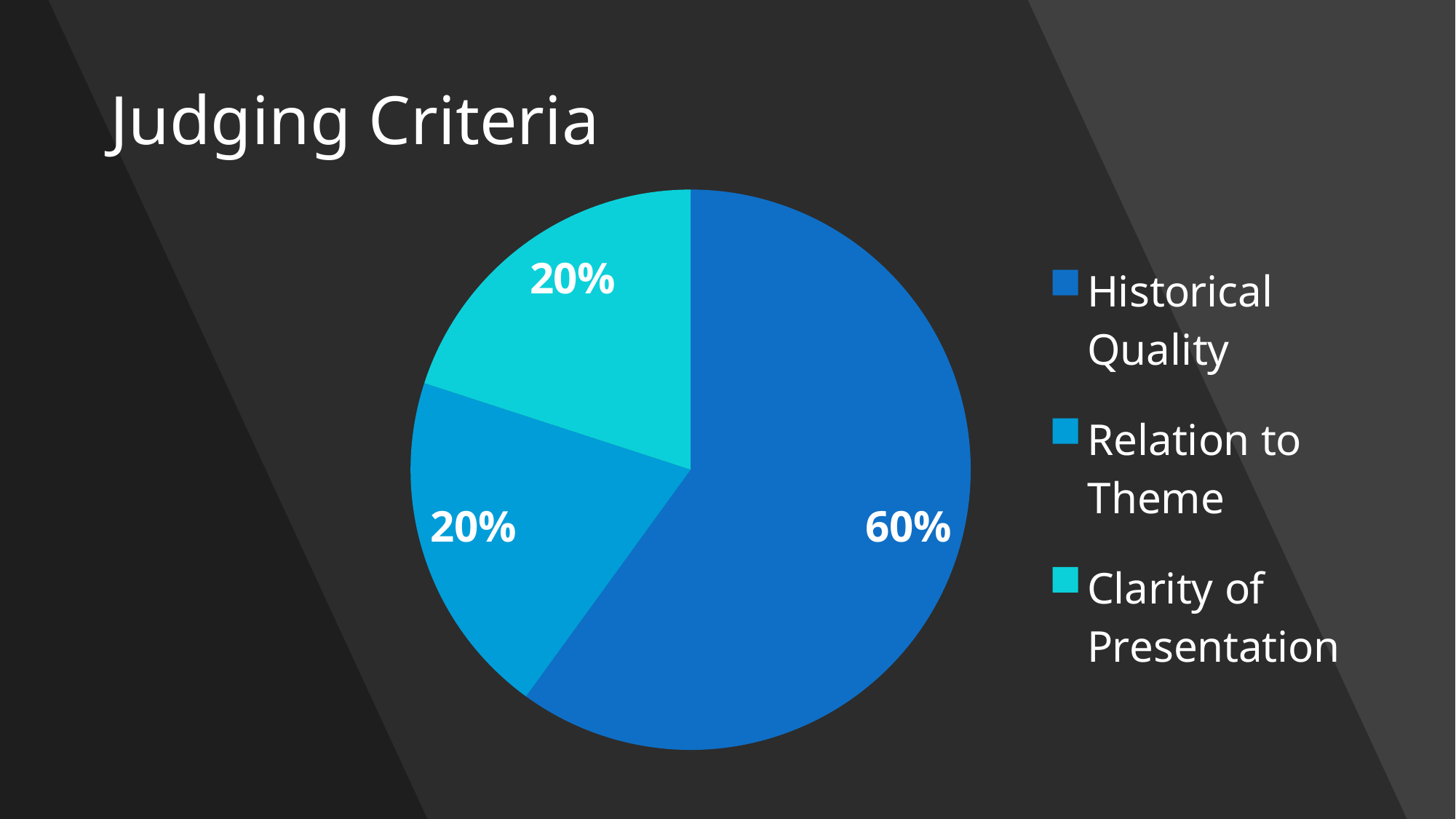
What is the title of the slide containing the pie chart? Judging Criteria How many entries does the legend list? 3 Which legend entry is shown in the lightest (cyan) colour? Clarity of Presentation What share of the pie does Clarity of Presentation take? 20% What kind of chart is shown on the slide? pie chart How many slices does the pie chart have? 3 What is the difference in percentage points between Historical Quality and Relation to Theme? 40 What share of the pie does Historical Quality take? 60% What share of the pie does Relation to Theme take? 20% What is the combined share of Relation to Theme and Clarity of Presentation? 40% Which category has the largest slice of the pie? Historical Quality Which is larger, the slice for Historical Quality or the slice for Clarity of Presentation? Historical Quality